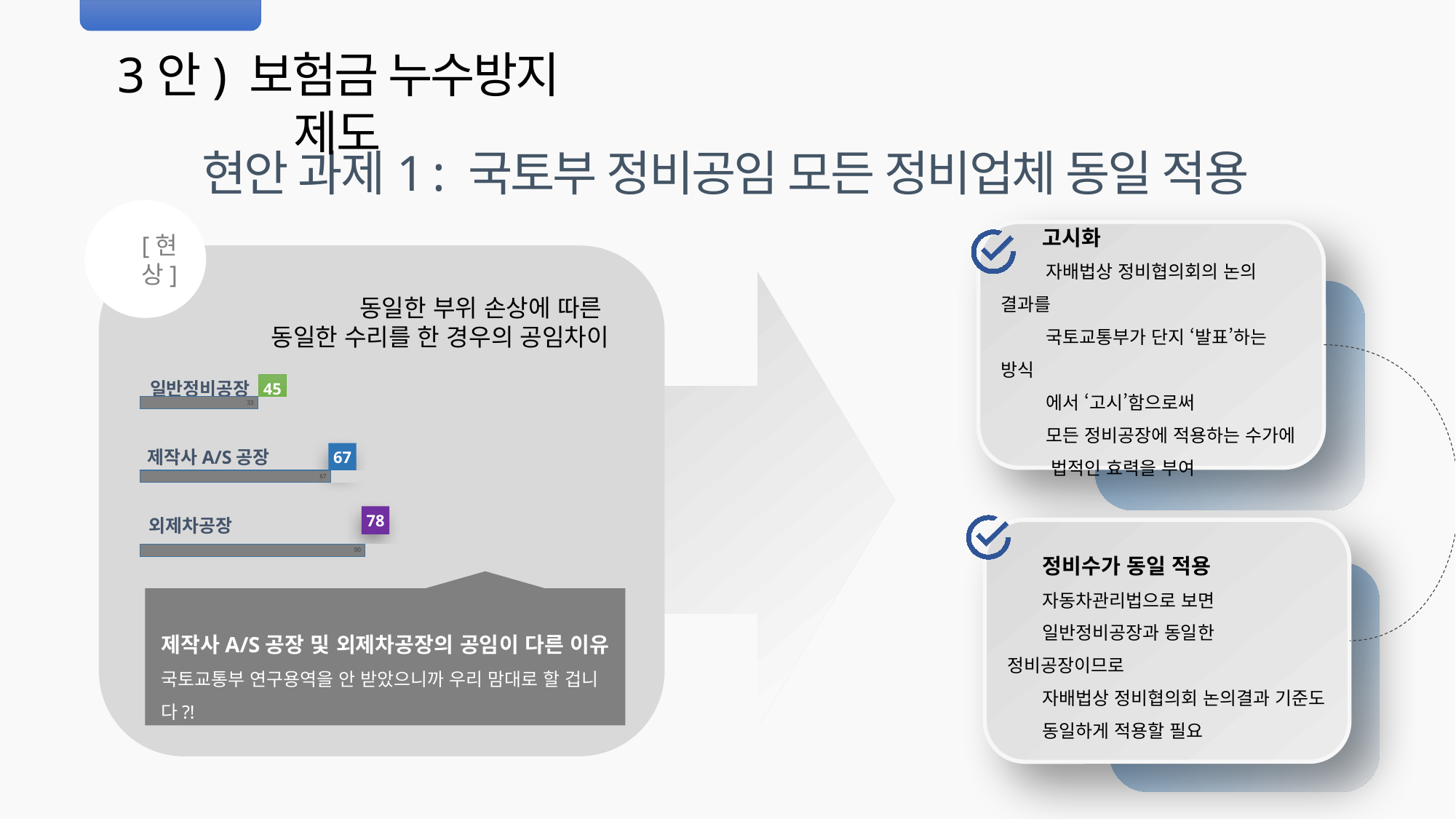
Which category has the highest value in the bar chart? 외제차공장 What colour is the value label box for 외제차공장? purple What kind of chart is shown on the left side of the slide? bar chart How many categories does the bar chart show? 3 Do the values increase or decrease going from 일반정비공장 down to 외제차공장? increase Which category has the lowest value in the bar chart? 일반정비공장 What is the title text above the bar chart? 동일한 부위 손상에 따른 동일한 수리를 한 경우의 공임차이 Which has the larger value, 제작사 A/S 공장 or 일반정비공장? 제작사 A/S 공장 What value is labelled for 제작사 A/S 공장 in the bar chart? 67